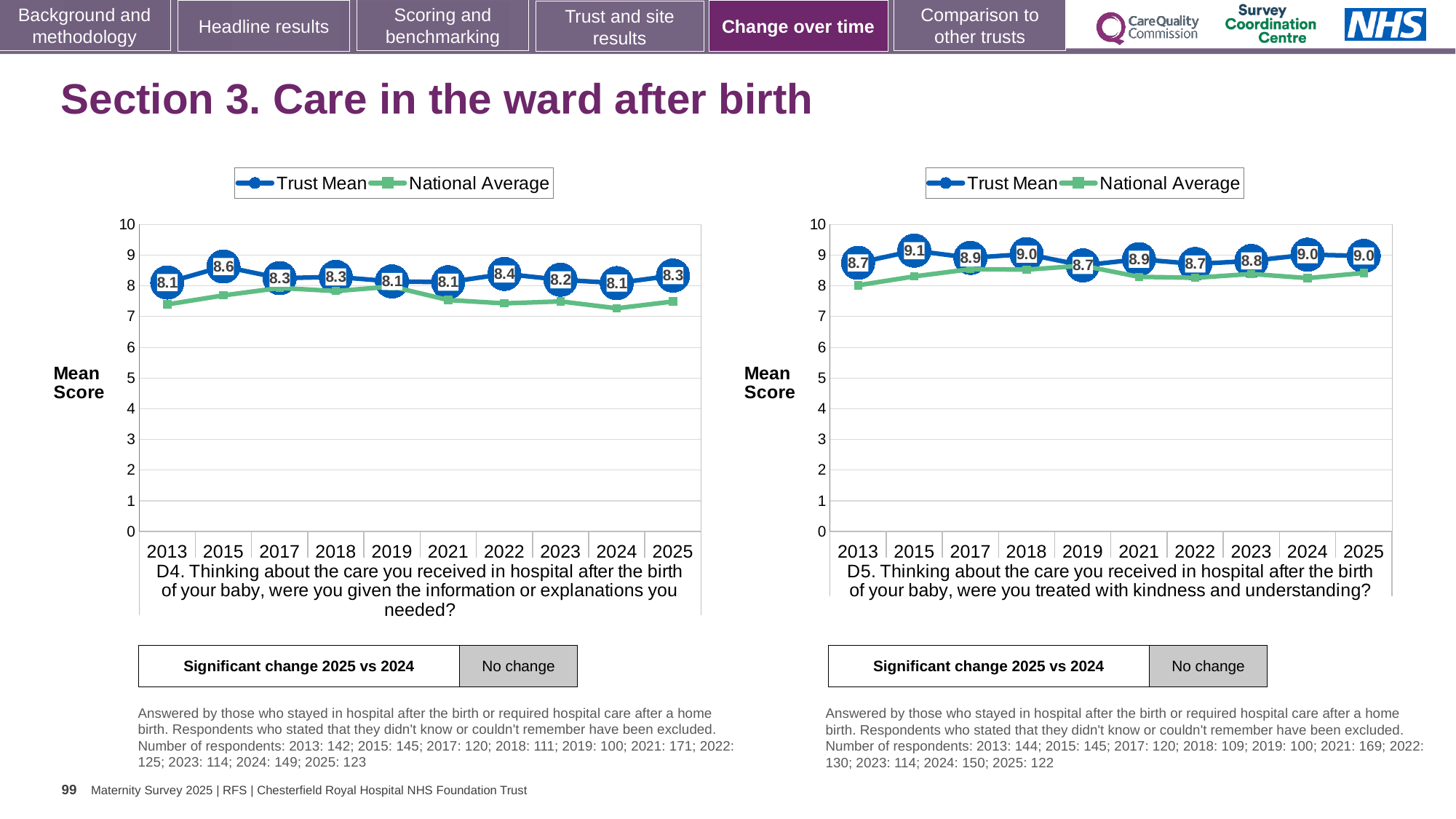
What kind of chart is the D4 chart (left)? Line chart On the D4 chart (left), which is larger, the Trust Mean in 2022 or in 2024? 2022 On the D5 chart (right), what is the Trust Mean for 2025? 9.0 On the D4 chart (left), what is the difference between the Trust Mean in 2015 and in 2013? 0.5 On the D5 chart (right), what is the difference between the Trust Mean in 2015 and in 2019? 0.4 On the D5 chart (right), in which year is the Trust Mean highest? 2015 On the D4 chart (left), in which year is the Trust Mean highest? 2015 On the D4 chart (left), is the National Average for 2013 greater or less than 8? less How many years are shown on the x axis of the D5 chart (right)? 10 How many series does the legend of the D4 chart (left) list? 2 On the D4 chart (left), what is the Trust Mean for 2015? 8.6 On the D5 chart (right), is the National Average for 2025 greater or less than 8? greater